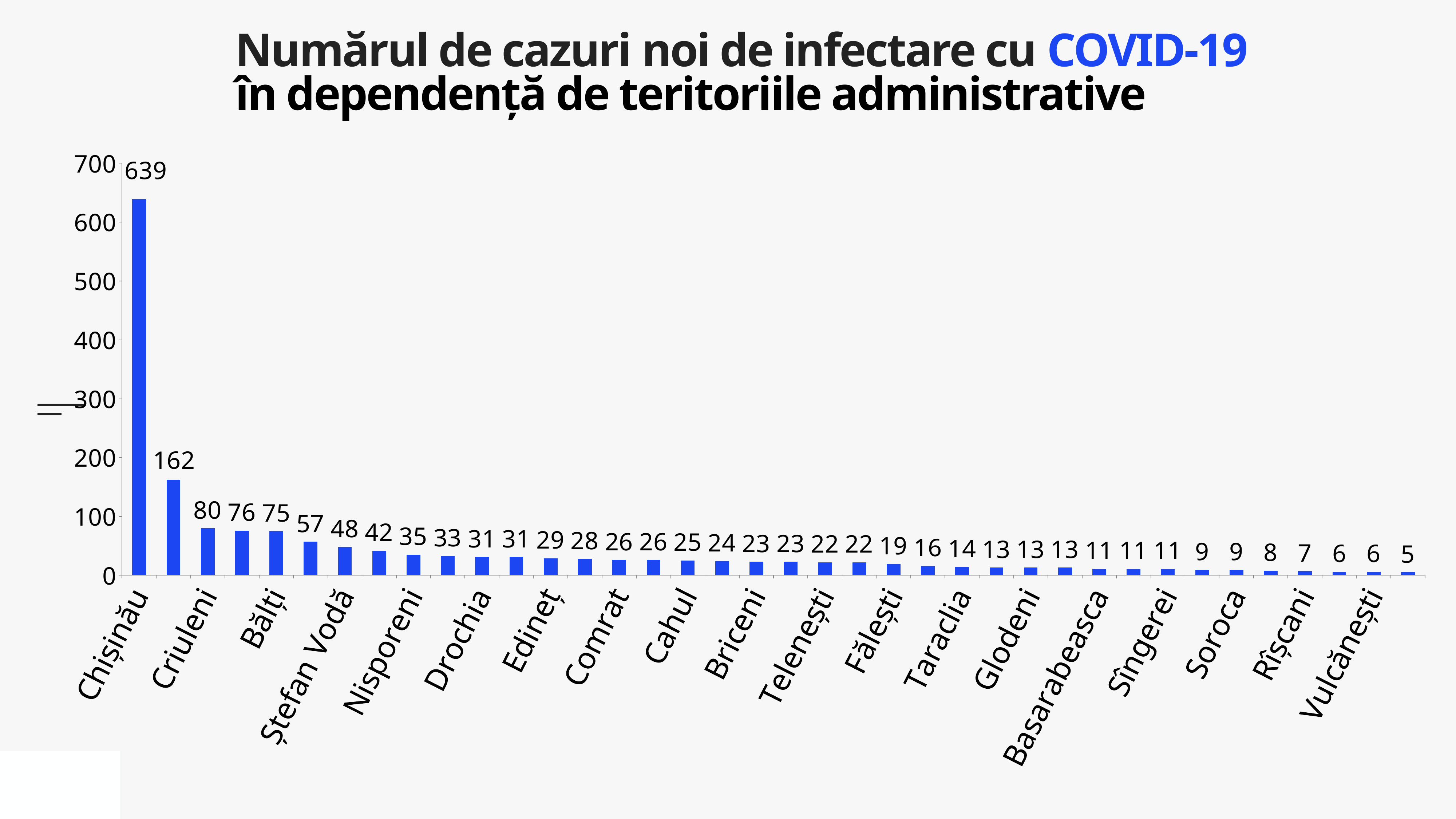
How many new COVID-19 cases are shown for Criuleni? 80 How many new COVID-19 cases are shown for Ștefan Vodă? 48 Which has more new cases, Criuleni or Bălți? Criuleni How many new COVID-19 cases are shown for Bălți? 75 Is the value for Chișinău greater or less than 600? greater Which territory has the highest number of new COVID-19 cases? Chișinău What is the difference between the values for Chișinău and Criuleni? 559 What kind of chart is shown on the slide? bar chart How many new COVID-19 cases are shown for Chișinău? 639 What is the highest value shown on the vertical axis? 700 Do the values rise or fall from left to right along the x axis? fall How many bars are plotted in the chart? 38